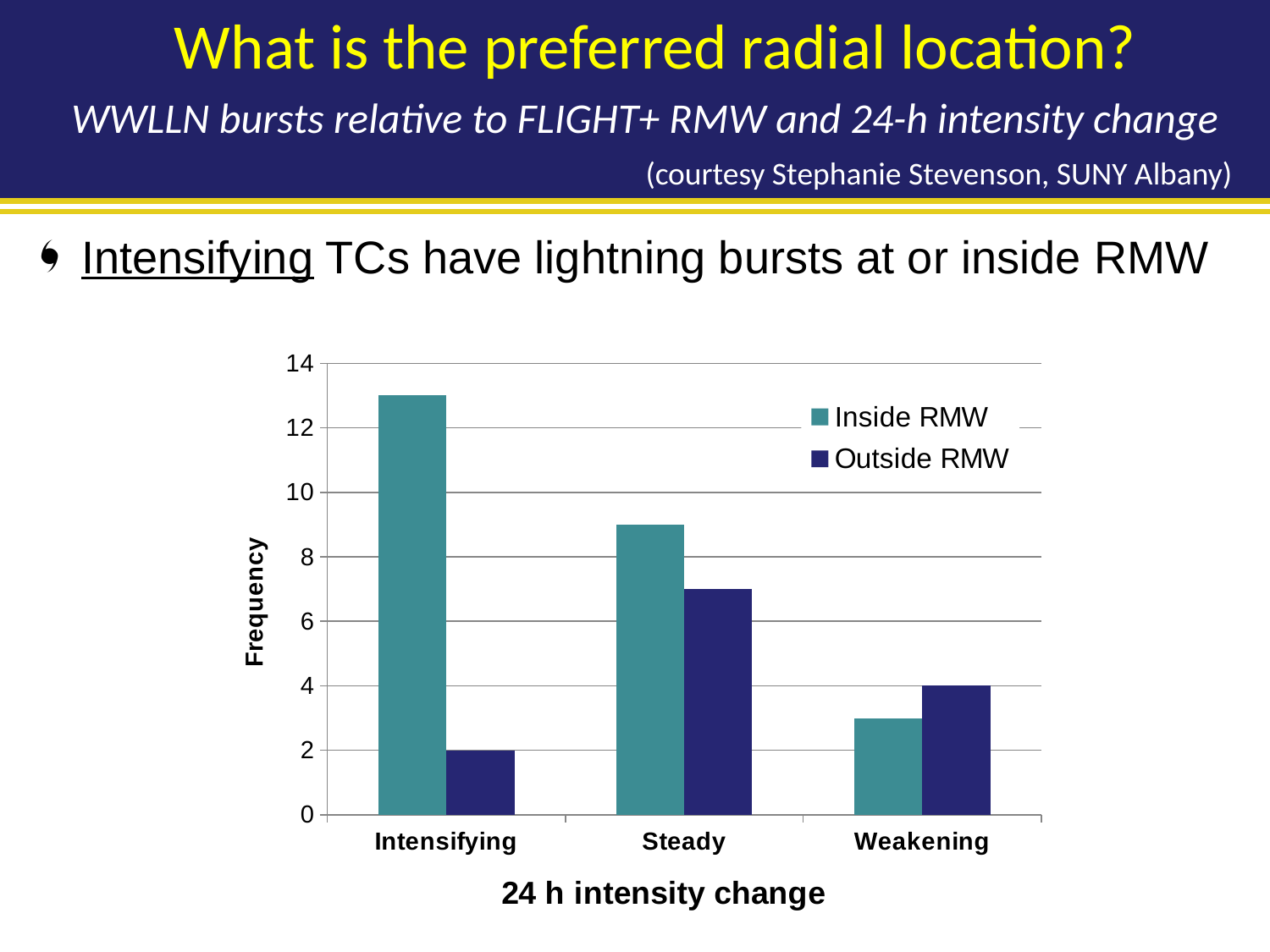
Which category has the highest Inside RMW frequency? Intensifying For Steady, which is larger: Inside RMW or Outside RMW? Inside RMW What type of chart is shown on the slide? bar chart Is the Inside RMW value for Steady greater or less than 8? greater What is the Outside RMW frequency for Intensifying? 2 Is the Inside RMW value for Weakening greater or less than 4? less How many categories are shown on the x axis? 3 How many series does the legend list? 2 Is the Inside RMW value for Intensifying greater or less than 12? greater What is the Outside RMW frequency for Weakening? 4 What is the difference between the Outside RMW frequency for Weakening and for Intensifying? 2 Which category has the lowest Outside RMW frequency? Intensifying